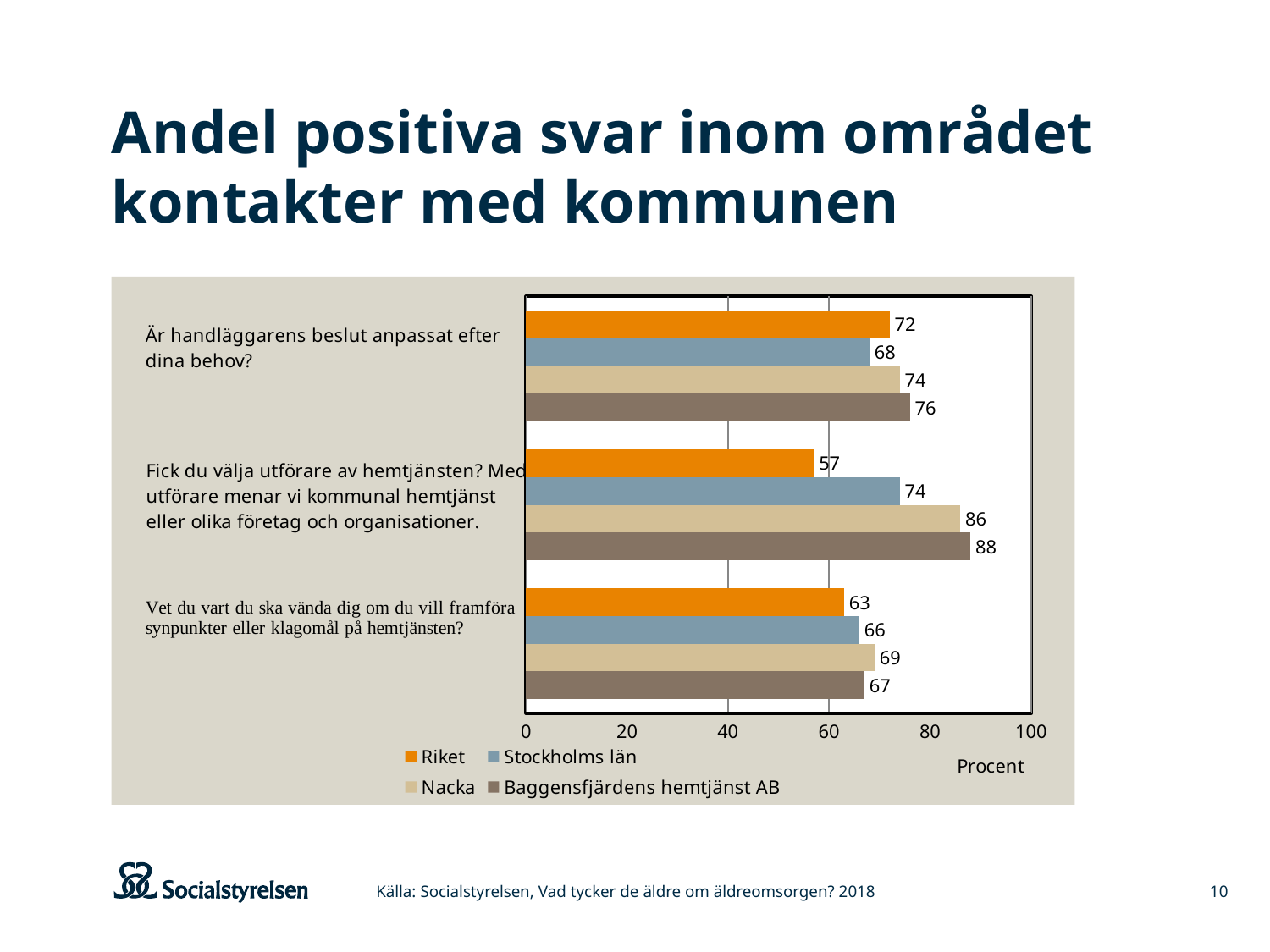
Which is larger on "Vet du vart du ska vända dig...": Nacka or Baggensfjärdens hemtjänst AB? Nacka What is the value for Baggensfjärdens hemtjänst AB on "Fick du välja utförare av hemtjänsten?" 88 Which series has the lowest value on "Är handläggarens beslut anpassat efter dina behov?" Stockholms län What is the value for Riket on "Är handläggarens beslut anpassat efter dina behov?" 72 What is the difference between Nacka and Riket on "Fick du välja utförare av hemtjänsten?" 29 Which series has the highest value on "Fick du välja utförare av hemtjänsten?" Baggensfjärdens hemtjänst AB What kind of chart is shown on the slide? bar chart What unit is shown on the x axis label? Procent What is the difference between Baggensfjärdens hemtjänst AB and Stockholms län on "Är handläggarens beslut anpassat efter dina behov?" 8 What is the value for Nacka on "Vet du vart du ska vända dig om du vill framföra synpunkter eller klagomål på hemtjänsten?" 69 How many series does the legend list? 4 How many question categories are shown on the chart? 3